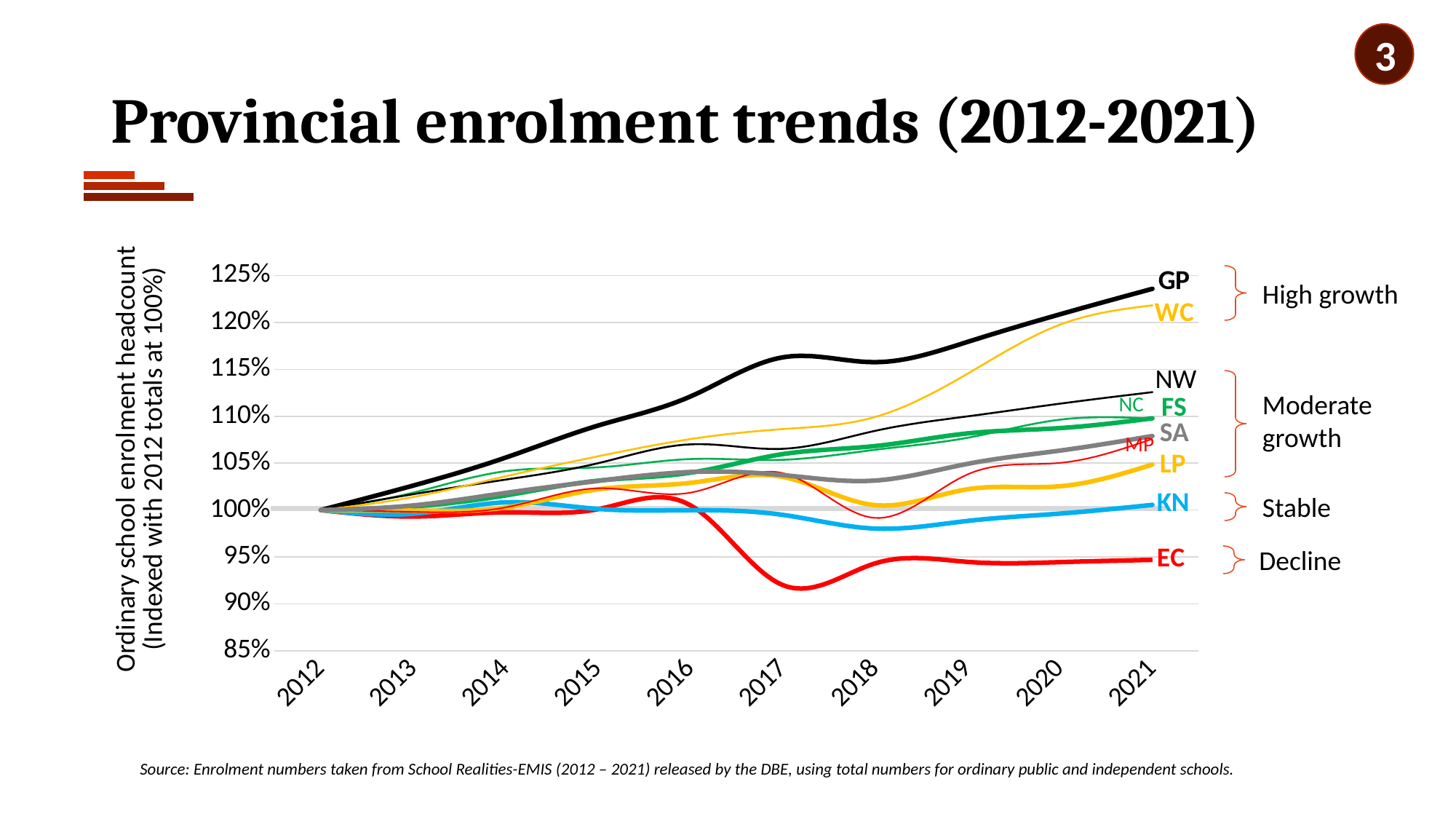
How many years are shown along the x axis of the chart? 10 Is the value for EC in 2017 greater or less than 95%? less What kind of chart is shown on the slide? line chart How many provinces (lines) are plotted on the chart? 10 What is the indexed enrolment value for every province in 2012? 100% Does the GP line rise or fall from 2012 to 2021? rise Is the value for WC in 2021 greater or less than 115%? greater Which province has the highest indexed enrolment in 2021? GP Which province is labelled as 'Decline' on the chart? EC Which province has the lowest indexed enrolment in 2021? EC Which is larger in 2021, the value for GP or the value for EC? GP Is the value for GP in 2021 greater or less than 120%? greater